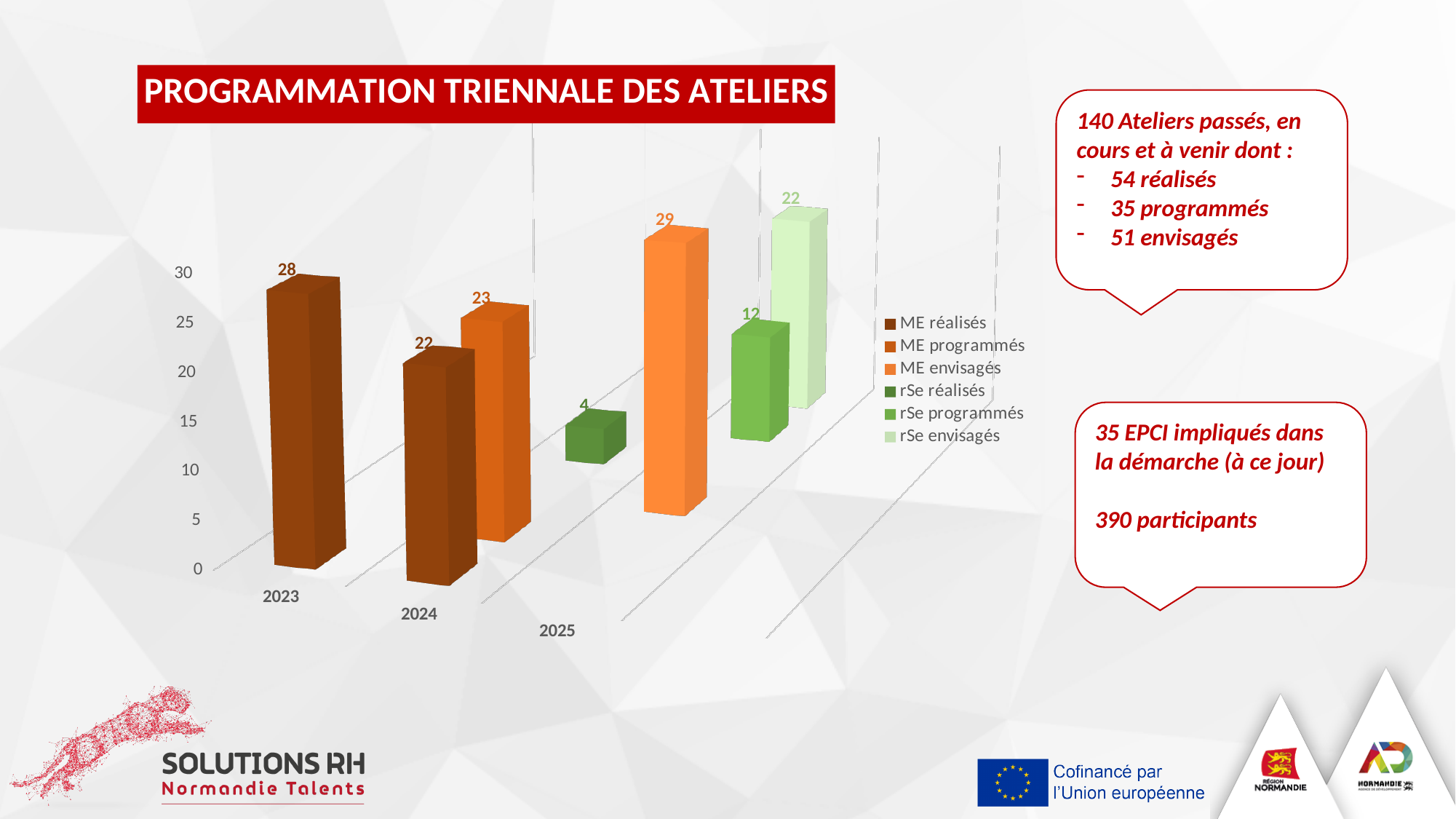
Which bar has the lowest value in the chart? rSe réalisés in 2024 (4) What is the value for ME envisagés in 2025? 29 Which bar has the highest value in the chart? ME envisagés in 2025 (29) What is the value for rSe envisagés in 2025? 22 What is the value for ME réalisés in 2023? 28 What kind of chart is shown on the slide? Bar chart What is the difference between ME réalisés in 2023 and ME réalisés in 2024? 6 How many years are shown on the x axis of the chart? 3 What is the value for ME programmés in 2024? 23 Which is larger: rSe programmés in 2025 or rSe envisagés in 2025? rSe envisagés in 2025 How many series does the legend list? 6 What is the value for rSe réalisés in 2024? 4